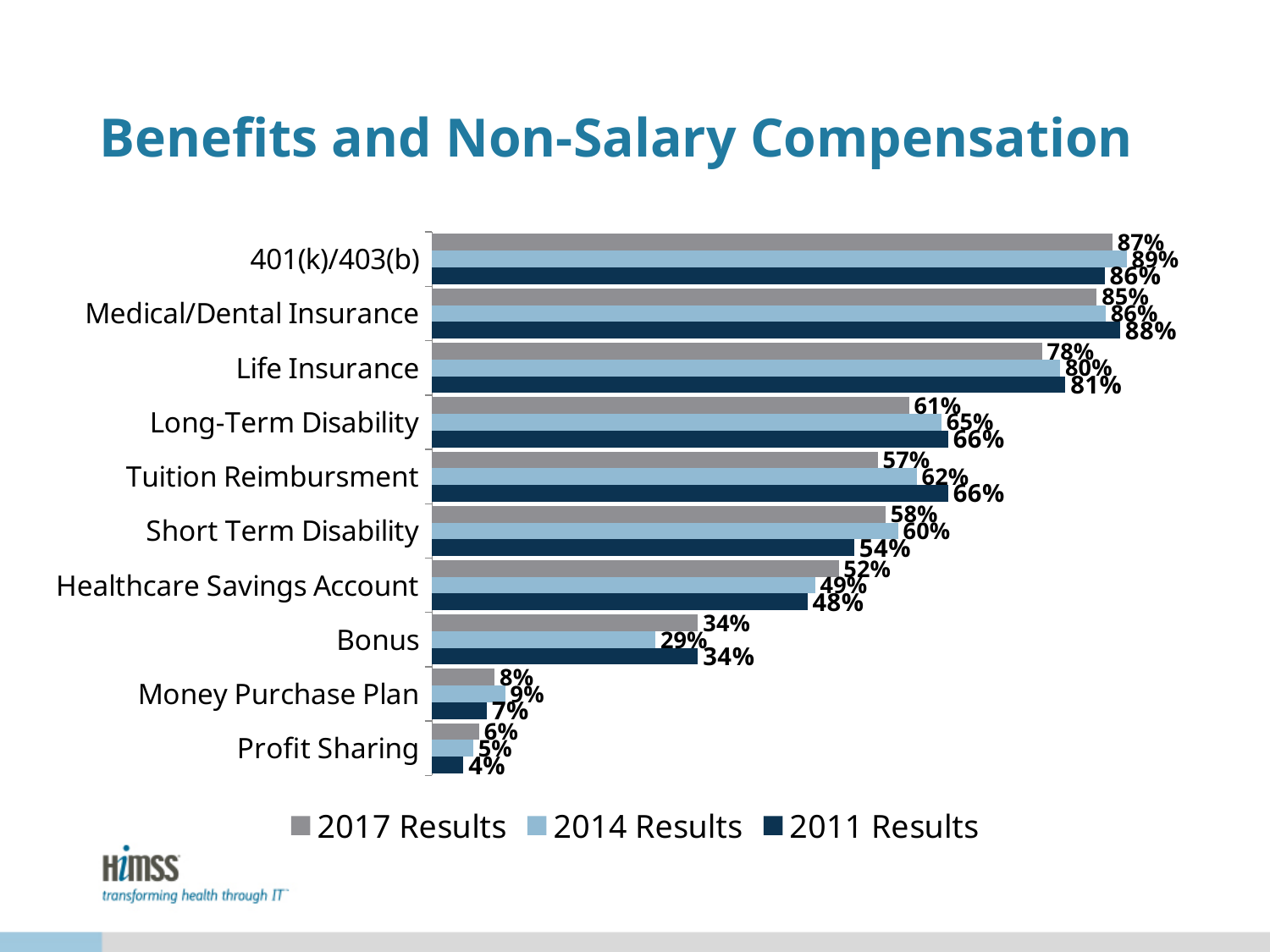
What is the title of the slide? Benefits and Non-Salary Compensation What is the 2014 Results value for Bonus? 29% Which is larger for Short Term Disability: the 2014 Results value or the 2011 Results value? 2014 Results Which category has the lowest 2011 Results value? Profit Sharing What is the 2011 Results value for Tuition Reimbursment? 66% Which category has the highest 2014 Results value? 401(k)/403(b) What kind of chart is shown on the slide? Bar chart How many series does the legend list? 3 Which series is shown in the darkest blue colour? 2011 Results What is the 2017 Results value for Life Insurance? 78% What is the difference between the 2011 Results and 2017 Results values for Long-Term Disability? 5% How many categories are shown on the chart? 10